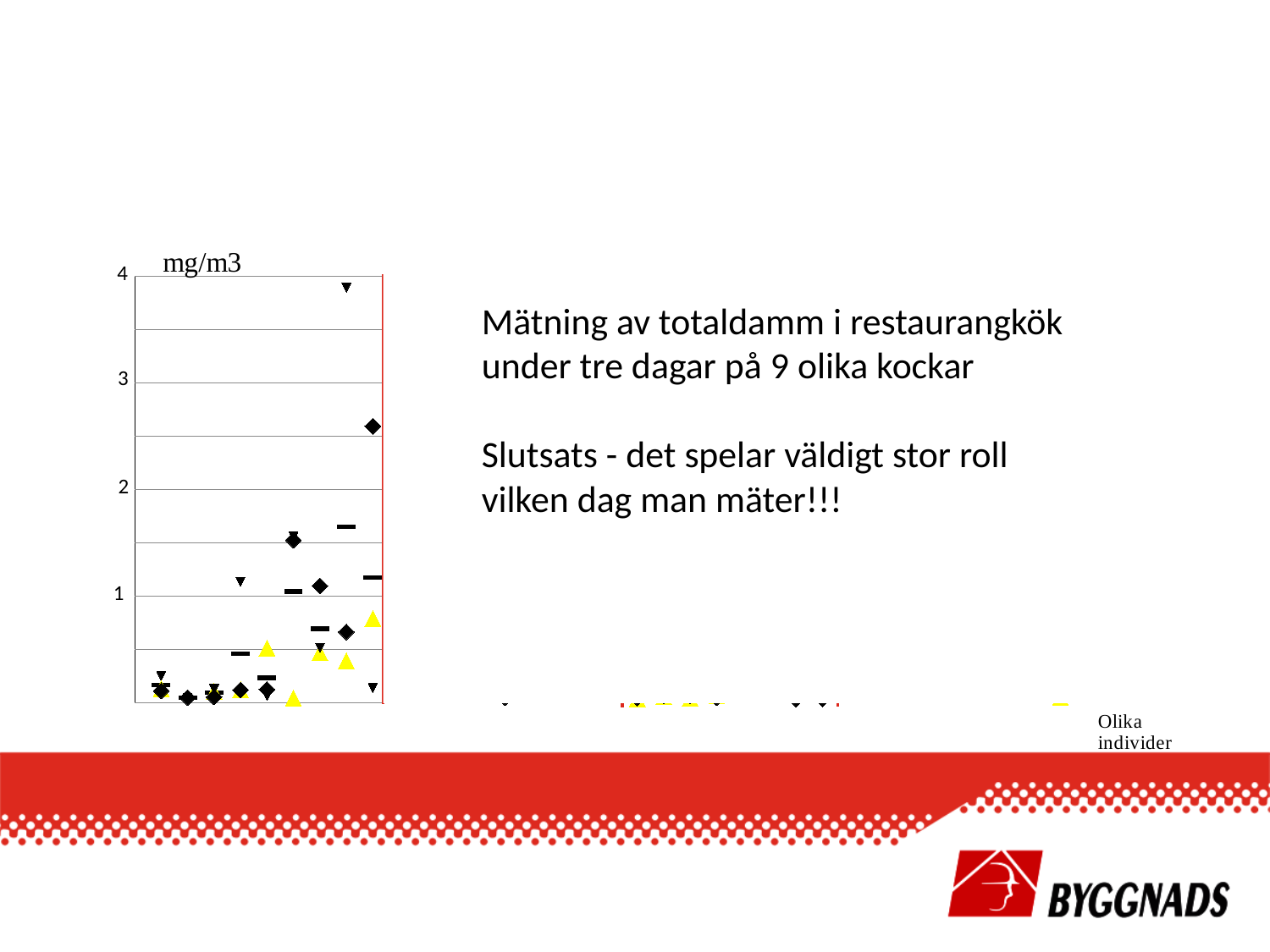
What label appears at the bottom right of the chart's x axis? Olika individer Is the highest plotted yellow triangle on the chart greater or less than 1? less Is the highest plotted diamond marker on the chart greater or less than 2? greater What is the highest value labelled on the chart's y axis? 4 Is the highest plotted point on the chart greater or less than 3? greater What unit is written at the top of the chart's y axis? mg/m3 How many numbered tick labels are shown on the chart's y axis? 4 What kind of chart is shown on the slide? scatter chart